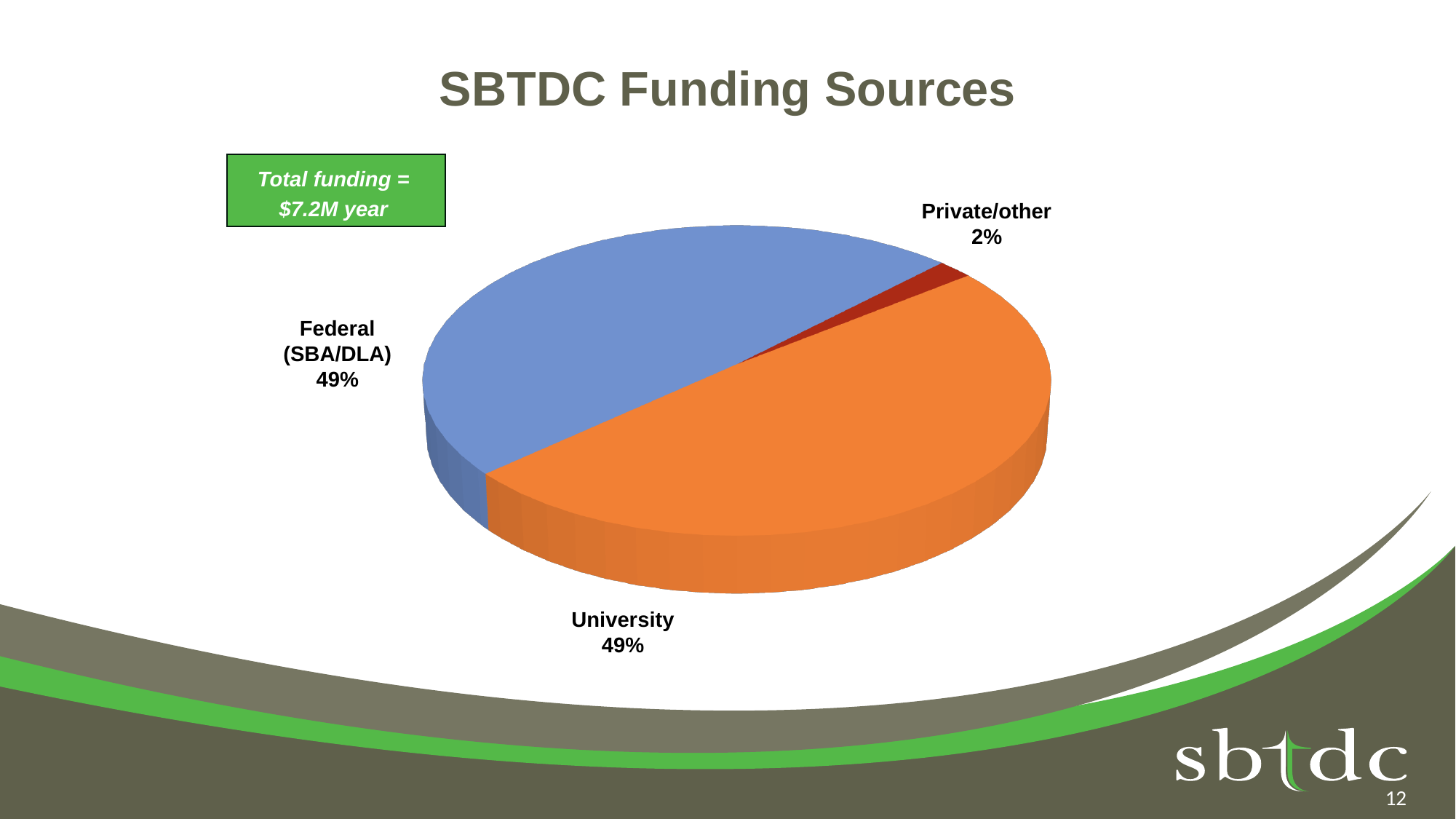
What kind of chart is shown on the slide? Pie chart What is the title of the chart? SBTDC Funding Sources What share of SBTDC funding comes from Federal (SBA/DLA)? 49% Which is larger, the University share or the Private/other share? University What is the combined share of Federal (SBA/DLA) and University funding? 98% What is the difference between the Federal (SBA/DLA) share and the Private/other share? 47% What share of SBTDC funding comes from Private/other? 2% How many funding sources are shown in the pie chart? 3 What total funding amount is stated in the green box on the slide? $7.2M year Which funding source has the smallest share of the pie? Private/other What share of SBTDC funding comes from University? 49%